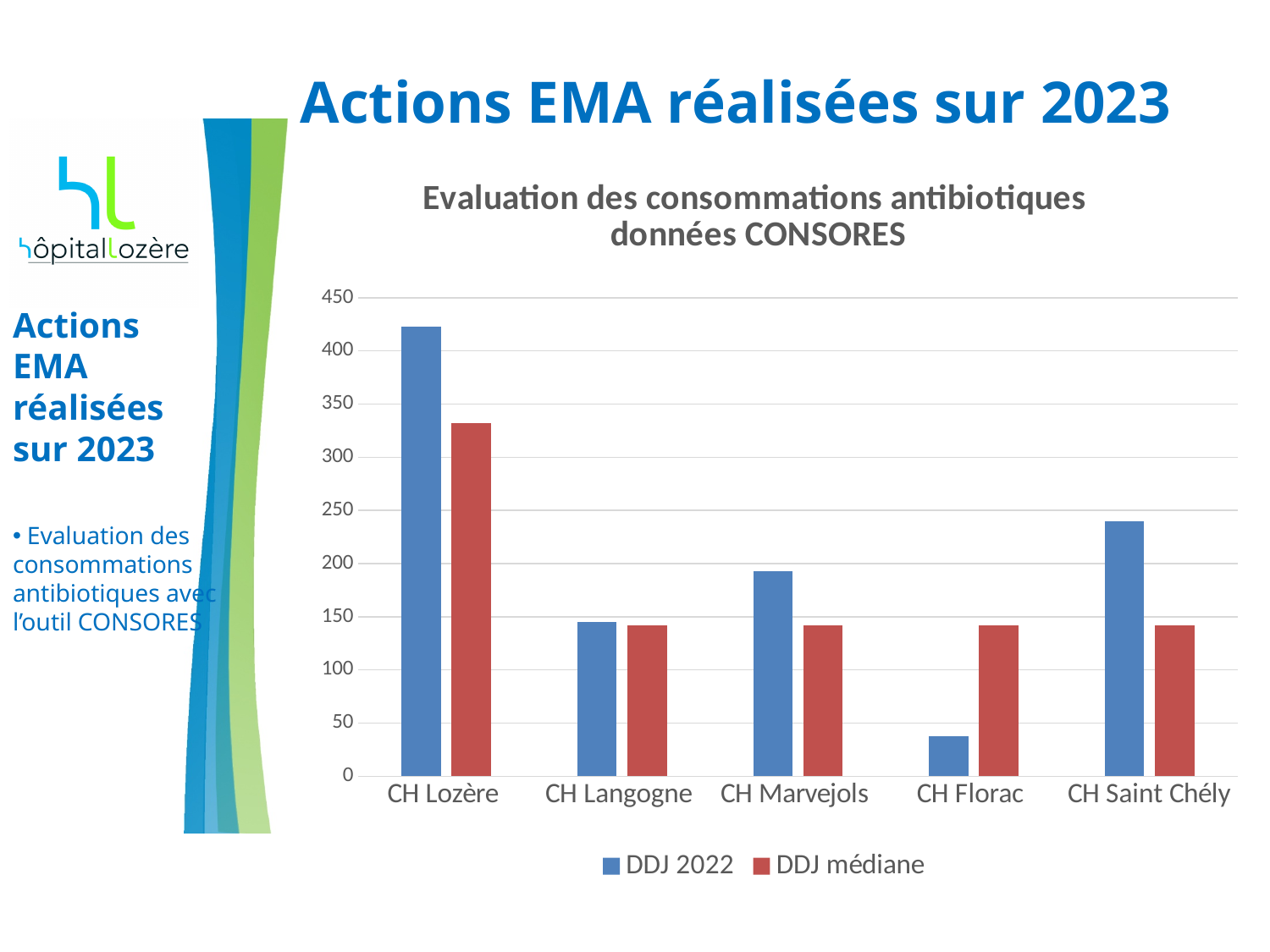
What kind of chart is shown on the slide? bar chart What colour are the DDJ médiane bars in the chart? red Which hospital has the highest DDJ 2022 value? CH Lozère Is the DDJ 2022 value for CH Florac greater or less than 50? less For CH Marvejols, which is larger: DDJ 2022 or DDJ médiane? DDJ 2022 Is the DDJ 2022 value for CH Lozère greater or less than 400? greater For CH Florac, which is larger: DDJ 2022 or DDJ médiane? DDJ médiane Is the DDJ 2022 value for CH Saint Chély greater or less than 200? greater How many hospitals (categories) are shown on the x axis of the chart? 5 Which hospital has the lowest DDJ 2022 value? CH Florac How many series does the chart legend list? 2